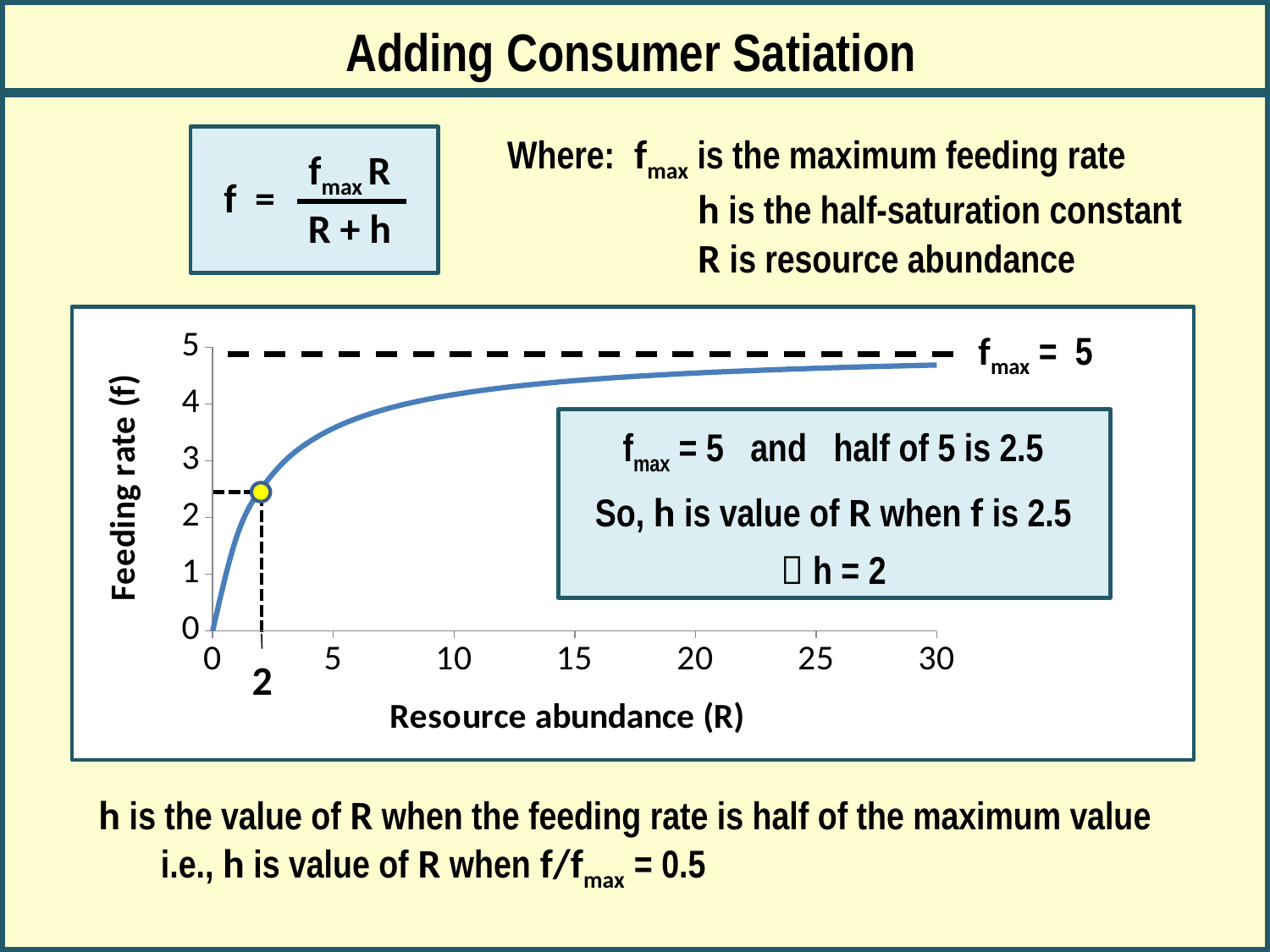
What is the feeding rate (f) at the highlighted yellow point on the curve? 2.5 What is the highest value shown on the x axis of the chart? 30 What is the label of the x axis of the chart? Resource abundance (R) What value of f_max is marked by the horizontal dashed line on the chart? 5 What kind of chart is shown on the slide? line chart Does the feeding rate rise or fall as resource abundance increases along the x axis? rise Is the feeding rate at a resource abundance of 30 greater or less than 5? less What is the resource abundance (R) at the highlighted yellow point on the curve? 2 Which has the larger feeding rate on the curve: a resource abundance of 5 or of 20? 20 Is the feeding rate at a resource abundance of 10 greater or less than 3? greater What value of h does the chart's annotation box give? h = 2 What is the label of the y axis of the chart? Feeding rate (f)